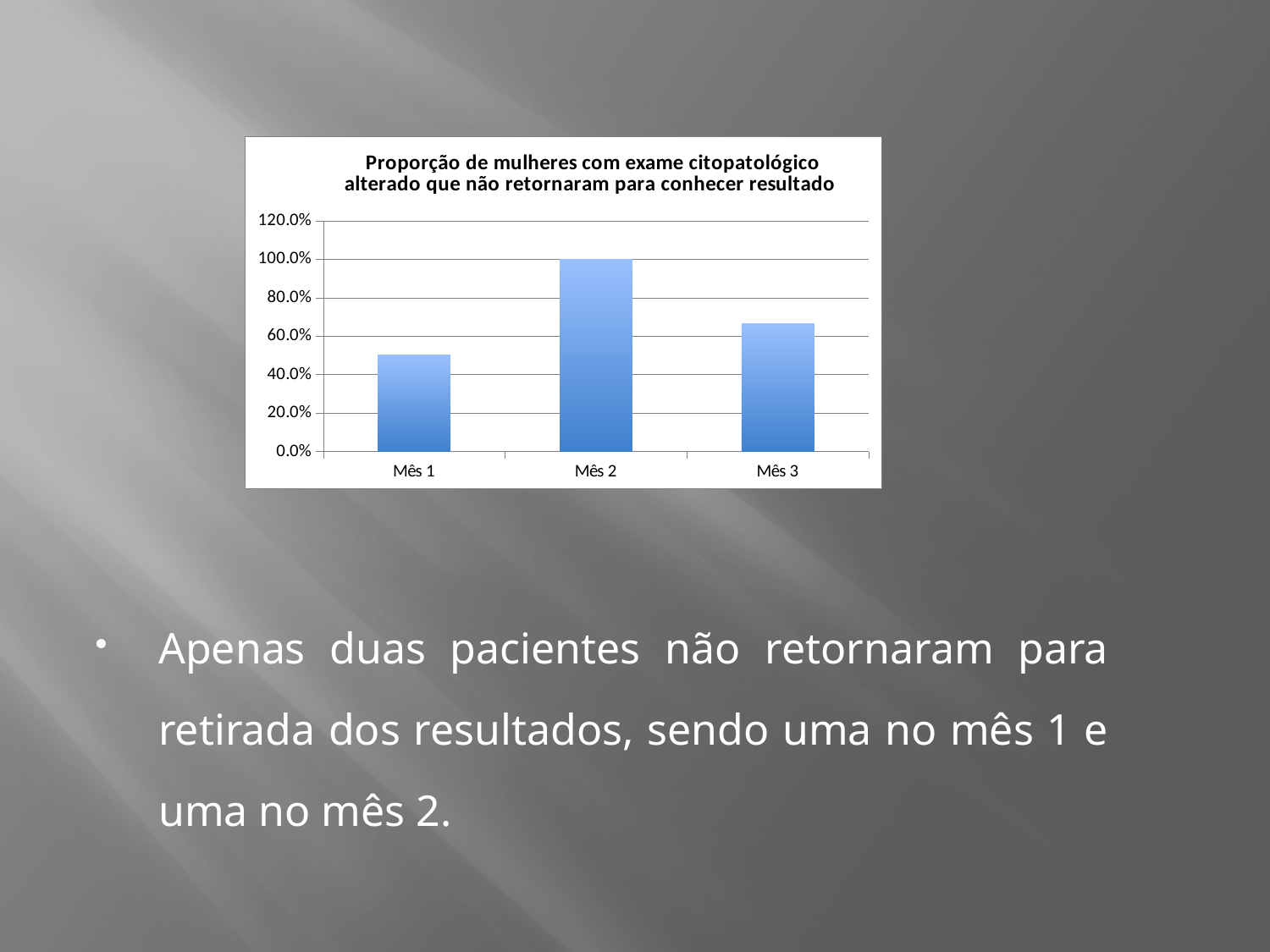
Is the value for Mês 3 greater or less than 60.0%? greater Is the value for Mês 3 greater or less than 80.0%? less Is the value for Mês 1 greater or less than 40.0%? greater What is the title of the chart? Proporção de mulheres com exame citopatológico alterado que não retornaram para conhecer resultado Which month has the highest value in the chart? Mês 2 What kind of chart is shown on the slide? bar chart What is the value for Mês 2 in the chart? 100.0% Which is larger, the value for Mês 1 or the value for Mês 3? Mês 3 How many categories are shown on the x axis of the chart? 3 Which month has the lowest value in the chart? Mês 1 What is the highest tick value shown on the y axis of the chart? 120.0%